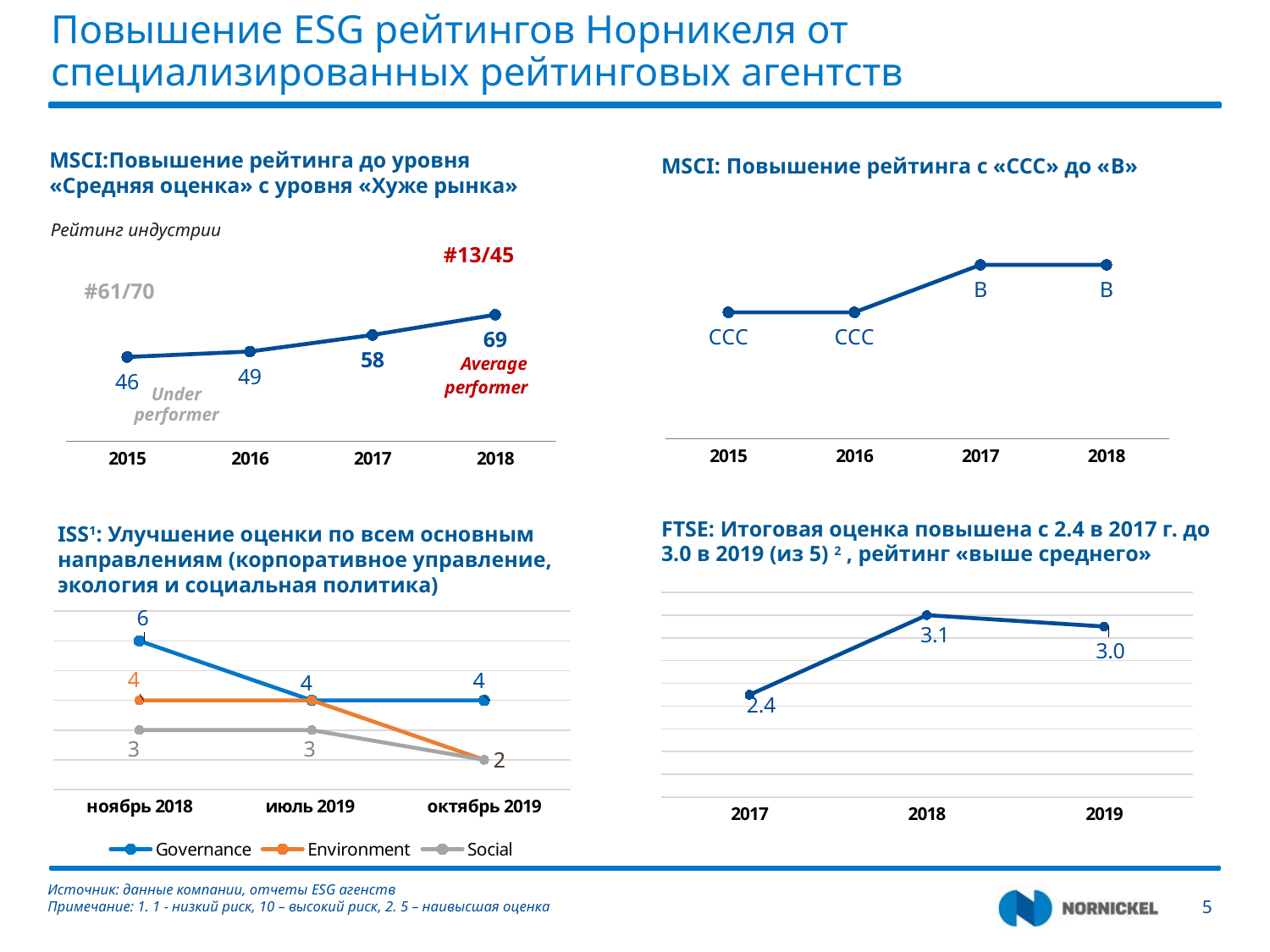
In the top-right MSCI chart, what rating is shown for 2016? CCC How many series does the legend of the bottom-left ISS chart list? 3 In the top-left MSCI industry rating chart, what is the difference between the 2018 and 2015 values? 23 In the bottom-right FTSE chart, which year has the highest value? 2018 What kind of chart is the bottom-right FTSE chart? line chart In the bottom-left ISS chart, what is the Environment value for октябрь 2019? 2 In the top-left MSCI industry rating chart, do the values rise or fall from 2015 to 2018? rise In the bottom-left ISS chart, which series has the highest value in ноябрь 2018? Governance In the top-left MSCI industry rating chart, what is the value for 2015? 46 In the top-left MSCI industry rating chart, what is the value for 2018? 69 In the top-right MSCI chart, what rating is shown for 2018? B In the bottom-left ISS chart, what is the Governance value for ноябрь 2018? 6